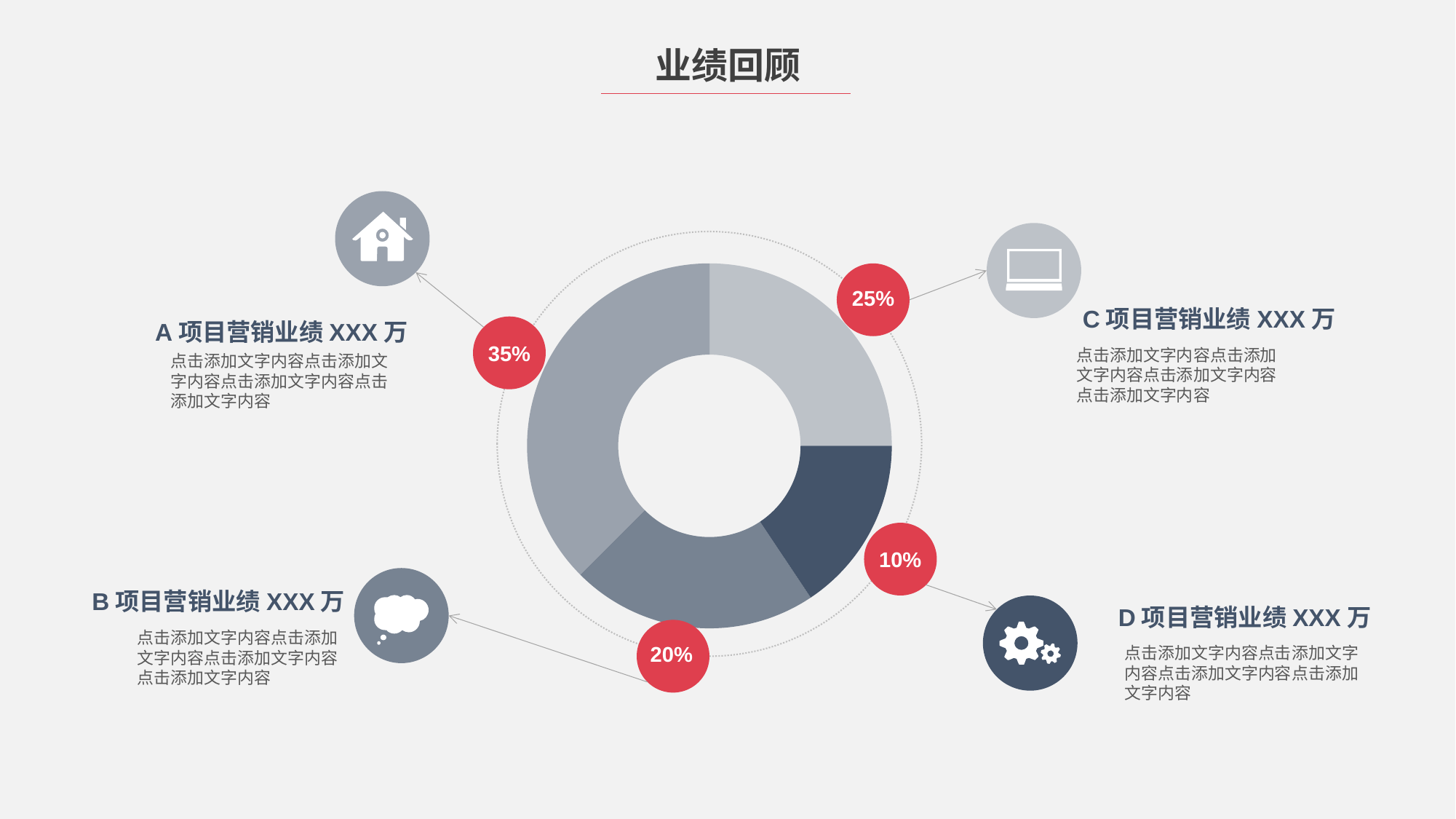
What is the percentage shown for D 项目 (D project) on the donut chart? 10% What is the total of the four percentages shown on the donut chart? 90% What is the percentage shown for B 项目 (B project) on the donut chart? 20% How many segments does the donut chart have? 4 What kind of chart is shown on the slide? Donut (pie) chart What is the title of the slide containing the donut chart? 业绩回顾 What is the difference in percentage points between A 项目 and D 项目? 25 Which is larger, the share for B 项目 or the share for C 项目? C 项目 What is the percentage shown for A 项目 (A project) on the donut chart? 35% What is the percentage shown for C 项目 (C project) on the donut chart? 25% Which project has the largest share on the donut chart? A 项目 Which project has the smallest share on the donut chart? D 项目